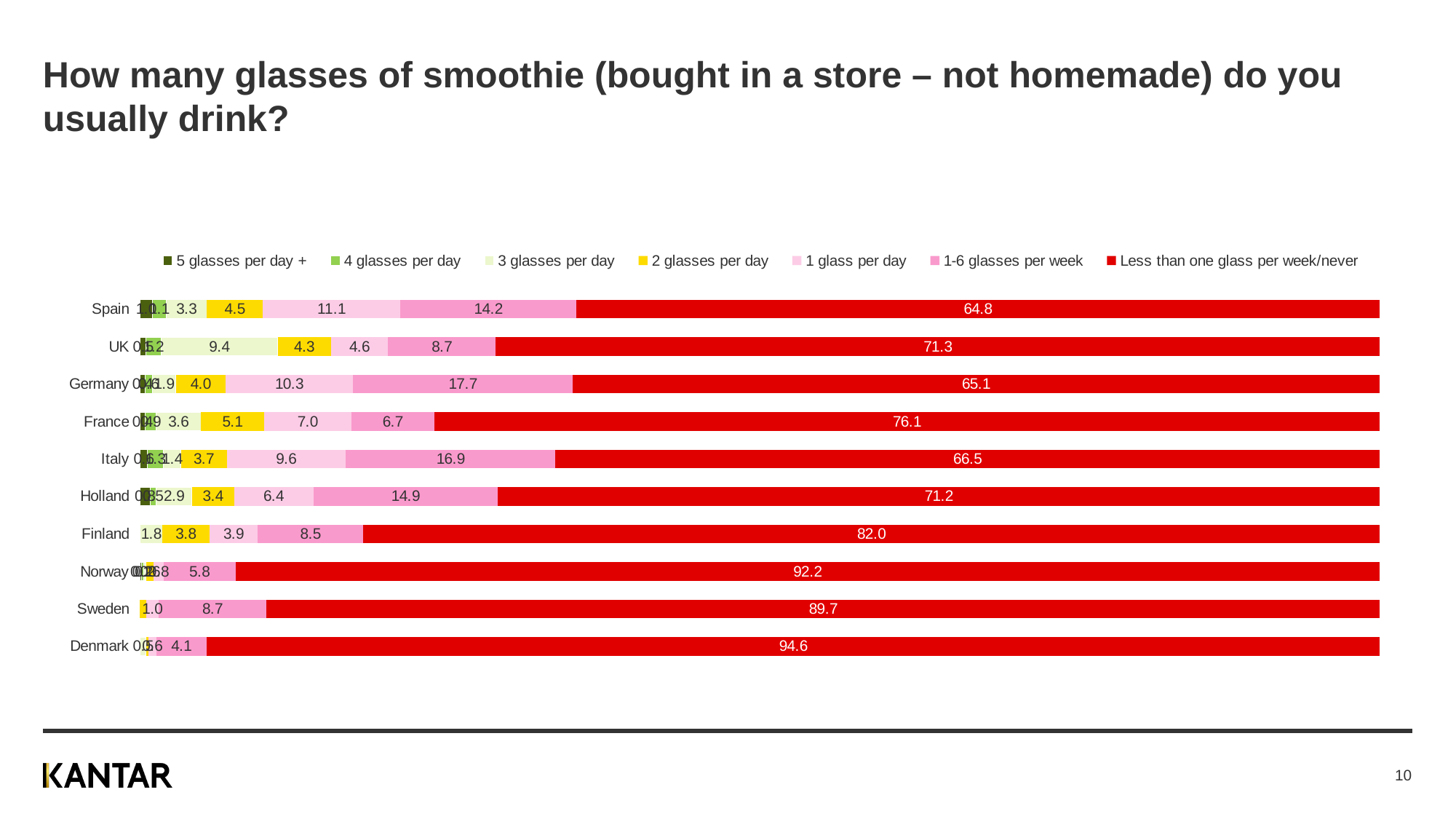
What is the value for '1 glass per day' for Italy? 9.6 What is the value for '2 glasses per day' for France? 5.1 How many series does the legend list? 7 How many countries are shown in the chart? 10 Which country has the highest value for 'Less than one glass per week/never'? Denmark What type of chart is shown on the slide? Stacked bar chart Which series is shown in red in the legend? Less than one glass per week/never Which country has a larger value for '1-6 glasses per week', Holland or UK? Holland Which country has the lowest value for 'Less than one glass per week/never'? Spain What is the value for '1-6 glasses per week' for Germany? 17.7 What is the difference between Norway's and Sweden's values for 'Less than one glass per week/never'? 2.5 What is the value for 'Less than one glass per week/never' for Spain? 64.8